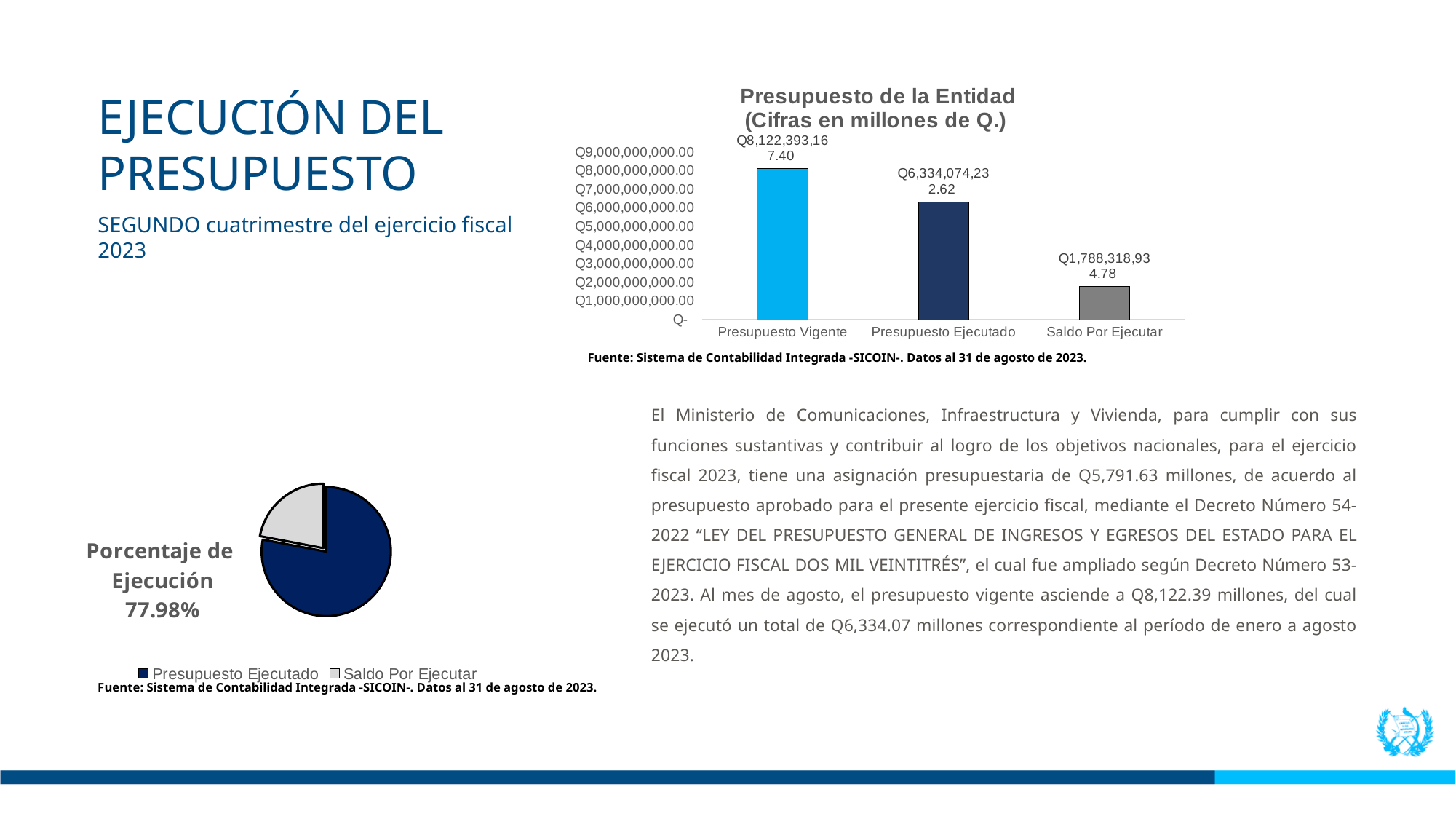
In the bar chart 'Presupuesto de la Entidad', what is the value for Presupuesto Vigente? Q8,122,393,167.40 In the bar chart 'Presupuesto de la Entidad', which is larger: Presupuesto Ejecutado or Saldo Por Ejecutar? Presupuesto Ejecutado In the bar chart 'Presupuesto de la Entidad', which category has the highest value? Presupuesto Vigente How many entries does the legend of the pie chart on the lower left list? 2 In the bar chart 'Presupuesto de la Entidad', what is the value for Presupuesto Ejecutado? Q6,334,074,232.62 How many bars are shown in the bar chart 'Presupuesto de la Entidad'? 3 In the bar chart 'Presupuesto de la Entidad', which category has the lowest value? Saldo Por Ejecutar In the bar chart 'Presupuesto de la Entidad', what is the difference between Presupuesto Vigente and Presupuesto Ejecutado? Q1,788,318,934.78 What type of chart is the chart titled 'Presupuesto de la Entidad'? bar chart In the pie chart on the lower left, what share does Presupuesto Ejecutado represent? 77.98% In the bar chart 'Presupuesto de la Entidad', what is the value for Saldo Por Ejecutar? Q1,788,318,934.78 In the bar chart 'Presupuesto de la Entidad', is the value for Presupuesto Ejecutado greater or less than Q5,000,000,000.00? greater